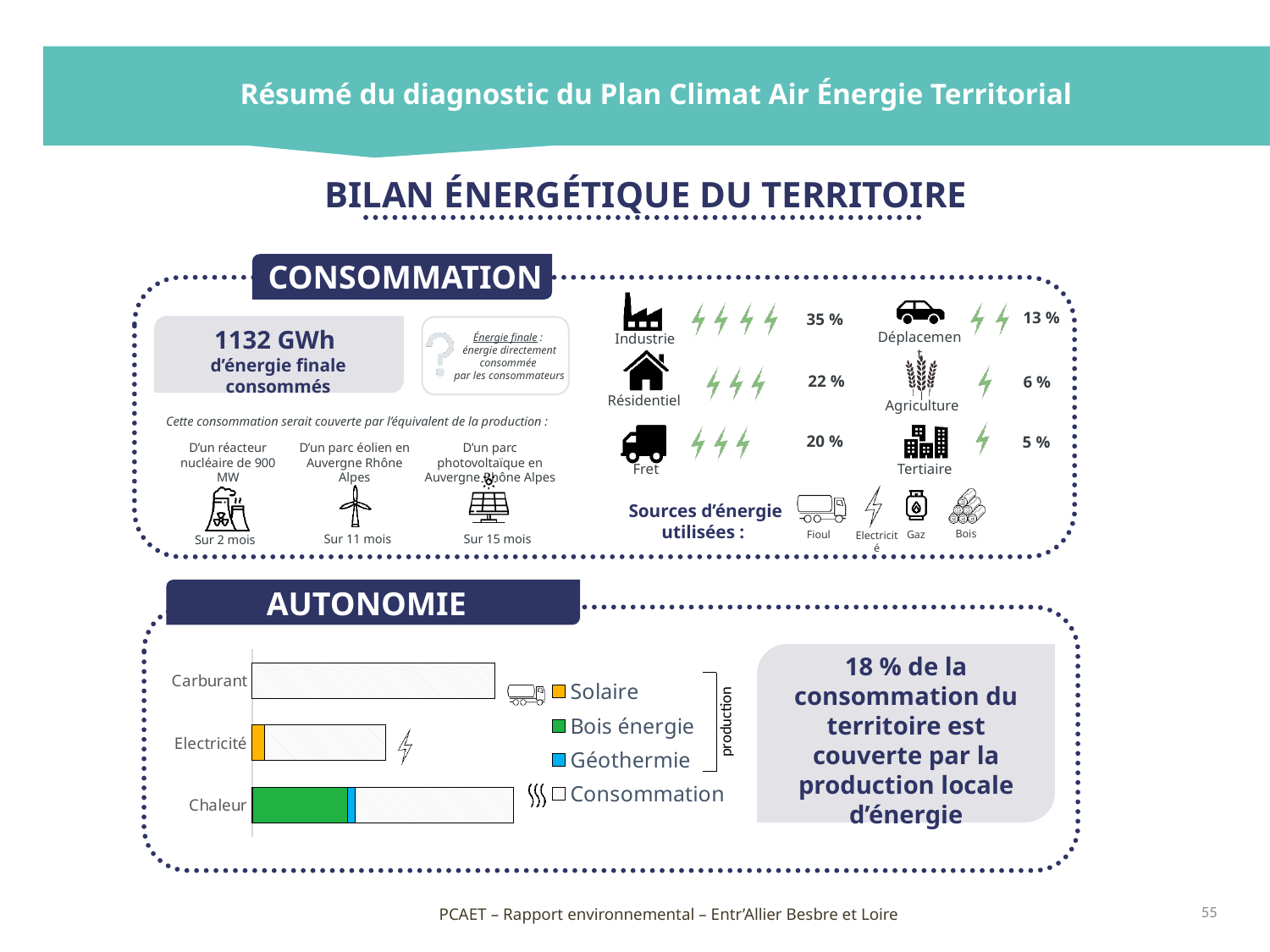
In the CONSOMMATION section, what share of energy consumption is attributed to Déplacements? 13 % In the CONSOMMATION section, which sector has the highest share of energy consumption? Industrie In the AUTONOMIE chart, is the Consommation bar longer for Carburant or for Chaleur? Carburant In the CONSOMMATION section, what share of energy consumption is attributed to Industrie? 35 % In the AUTONOMIE chart, how many categories are plotted on the vertical axis? 3 In the AUTONOMIE chart, which category has the shortest Consommation bar? Electricité In the AUTONOMIE chart, what colour represents Bois énergie? green In the AUTONOMIE chart, which category has the longest Consommation bar? Carburant In the AUTONOMIE chart, is the Consommation bar longer for Electricité or for Chaleur? Chaleur In the AUTONOMIE chart, how many series does the legend list? 4 In the AUTONOMIE chart, what are the legend entries? Solaire, Bois énergie, Géothermie, Consommation In the AUTONOMIE chart, what kind of chart is shown? bar chart